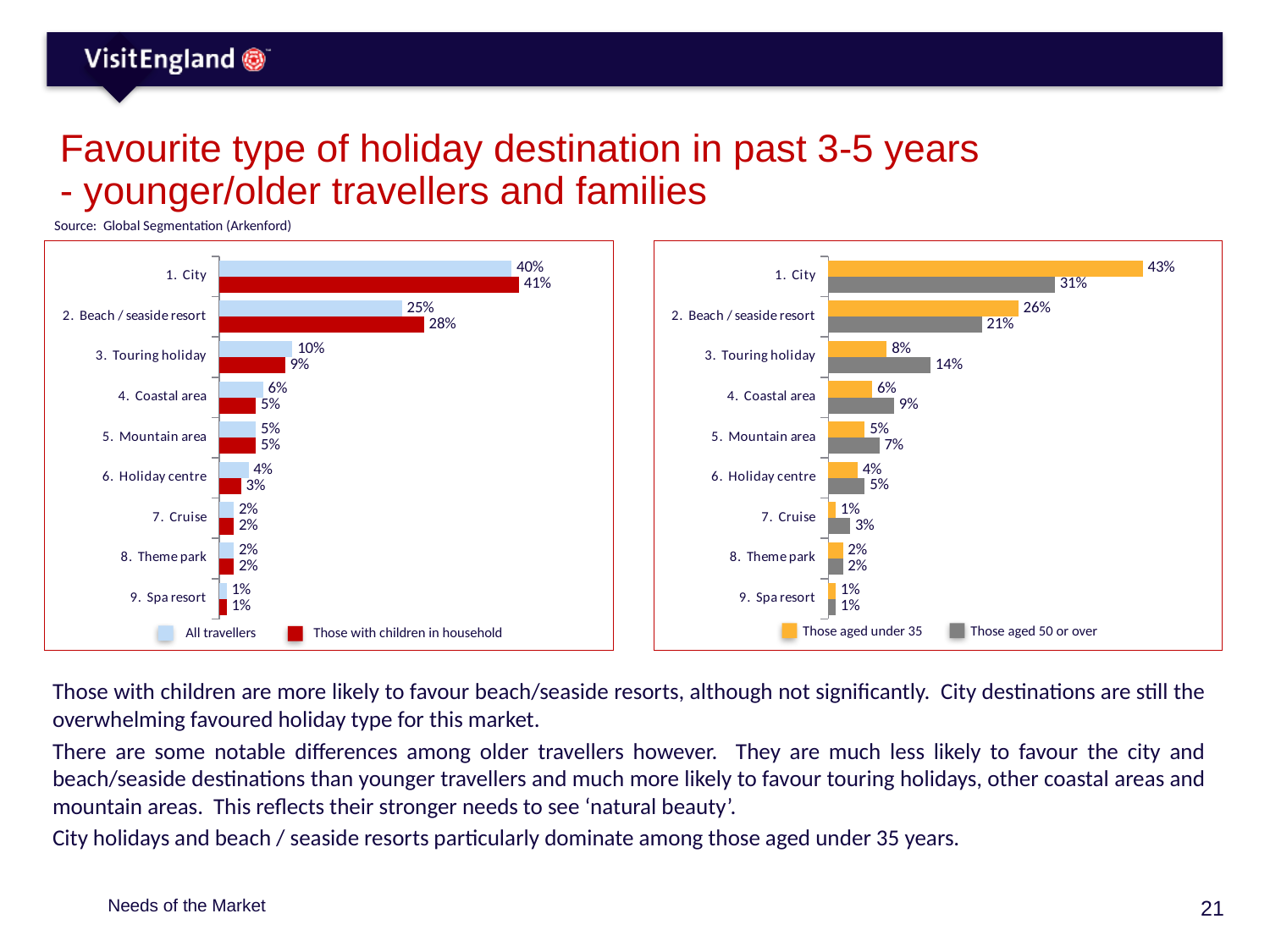
In the right chart, which is larger for Coastal area: those aged under 35 or those aged 50 or over? Those aged 50 or over In the right chart, what is the difference between those aged under 35 and those aged 50 or over for City? 12 percentage points In the right chart, which category has the lowest value for those aged under 35? Cruise and Spa resort (both 1%) What are the two series listed in the legend of the left chart? All travellers; Those with children in household What type of chart is the left chart? Bar chart In the left chart, what is the value for City among those with children in household? 41% How many series does the legend of the right chart list? 2 In the right chart, what is the value for Beach / seaside resort among those aged under 35? 26% How many categories are shown in the left chart? 9 In the right chart, what is the value for Touring holiday among those aged 50 or over? 14% In the left chart, what is the difference between those with children in household and All travellers for Beach / seaside resort? 3 percentage points In the left chart, which category has the highest value for All travellers? City